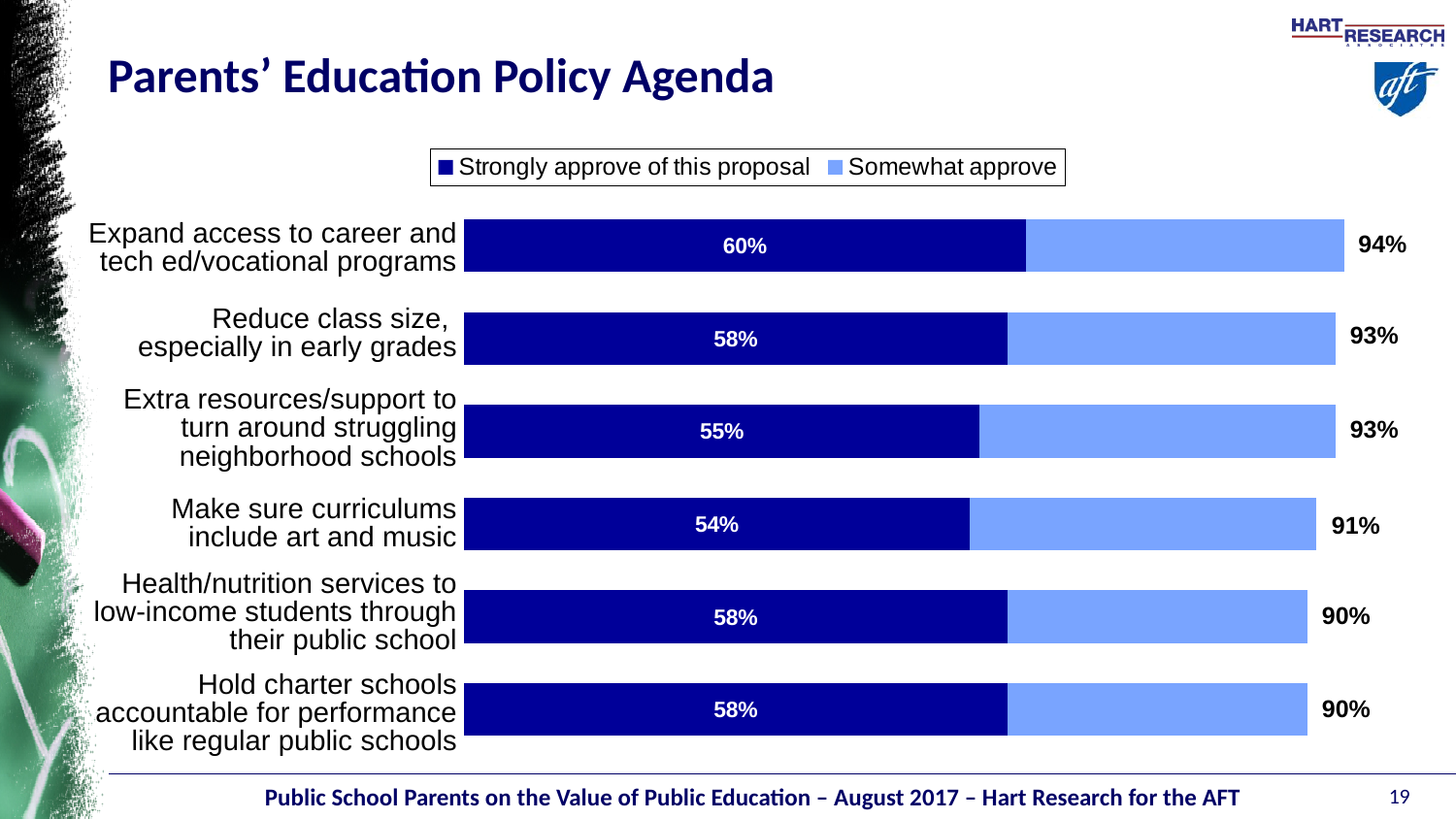
What is the title of the chart on the slide? Parents' Education Policy Agenda What is the total approval (strongly plus somewhat) for 'Make sure curriculums include art and music'? 91% What is the difference between the total approval and the strongly approve share for 'Reduce class size, especially in early grades'? 35% What is the total approval for 'Hold charter schools accountable for performance like regular public schools'? 90% Which proposal has the highest total approval? Expand access to career and tech ed/vocational programs Which has a higher strongly approve share: 'Expand access to career and tech ed/vocational programs' or 'Make sure curriculums include art and music'? Expand access to career and tech ed/vocational programs What kind of chart is shown on the slide? Stacked bar chart What percentage strongly approve of extra resources/support to turn around struggling neighborhood schools? 55% How many series does the legend list? 2 Which proposal has the lowest share of parents who strongly approve? Make sure curriculums include art and music What percentage of parents strongly approve of expanding access to career and tech ed/vocational programs? 60% How many proposals (categories) are shown in the chart? 6